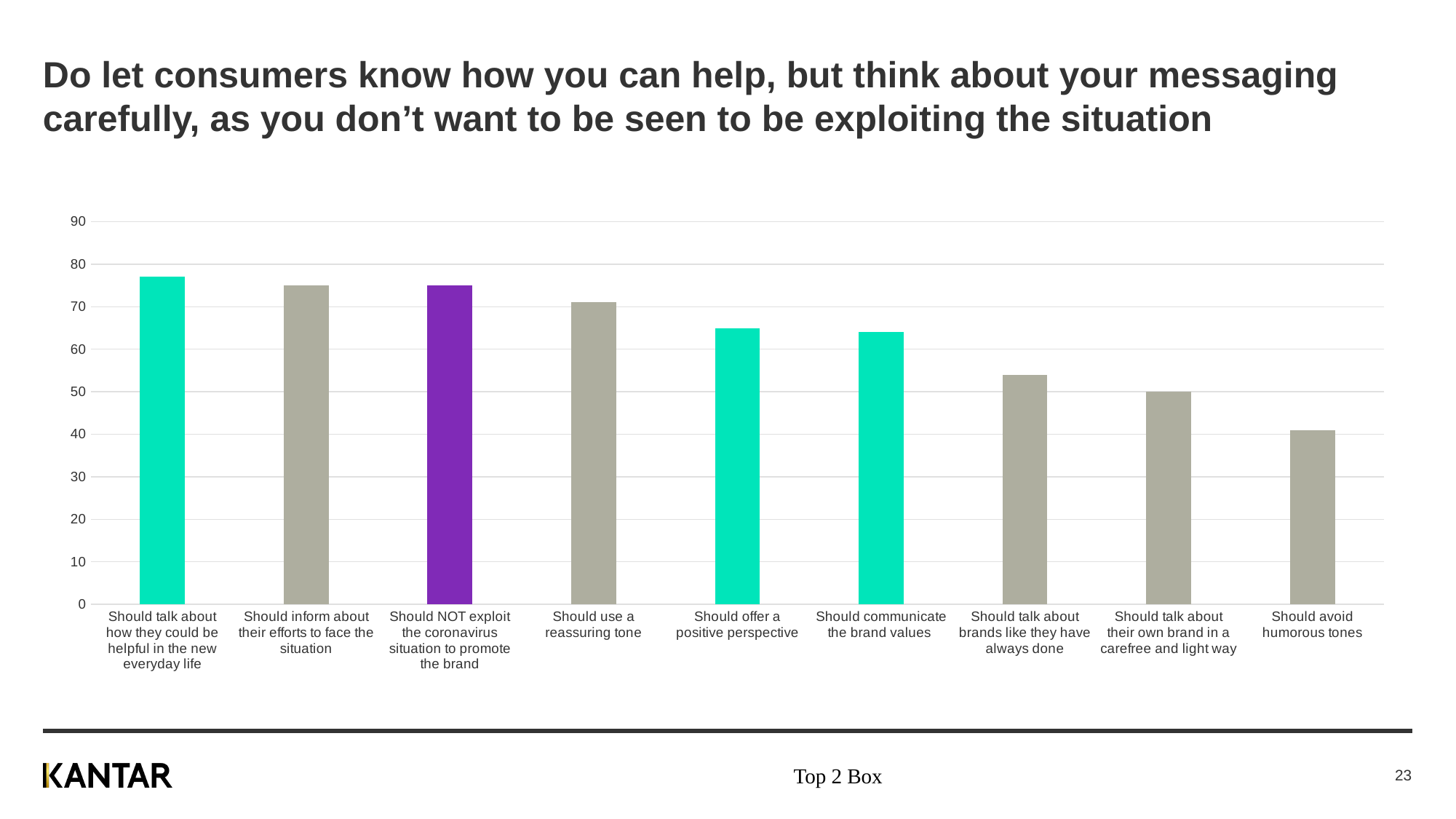
Is the value for "Should NOT exploit the coronavirus situation to promote the brand" greater or less than 70? greater Is the value for "Should talk about how they could be helpful in the new everyday life" greater or less than 70? greater Which is larger: the value for "Should use a reassuring tone" or the value for "Should avoid humorous tones"? Should use a reassuring tone Which category has the lowest value in the chart? Should avoid humorous tones Which is larger: the value for "Should offer a positive perspective" or the value for "Should talk about brands like they have always done"? Should offer a positive perspective What colour is the bar for "Should NOT exploit the coronavirus situation to promote the brand"? purple Do the bar values generally rise or fall from left to right along the x axis? fall Is the value for "Should avoid humorous tones" greater or less than 50? less What kind of chart is shown on the slide? bar chart How many categories are plotted in the chart? 9